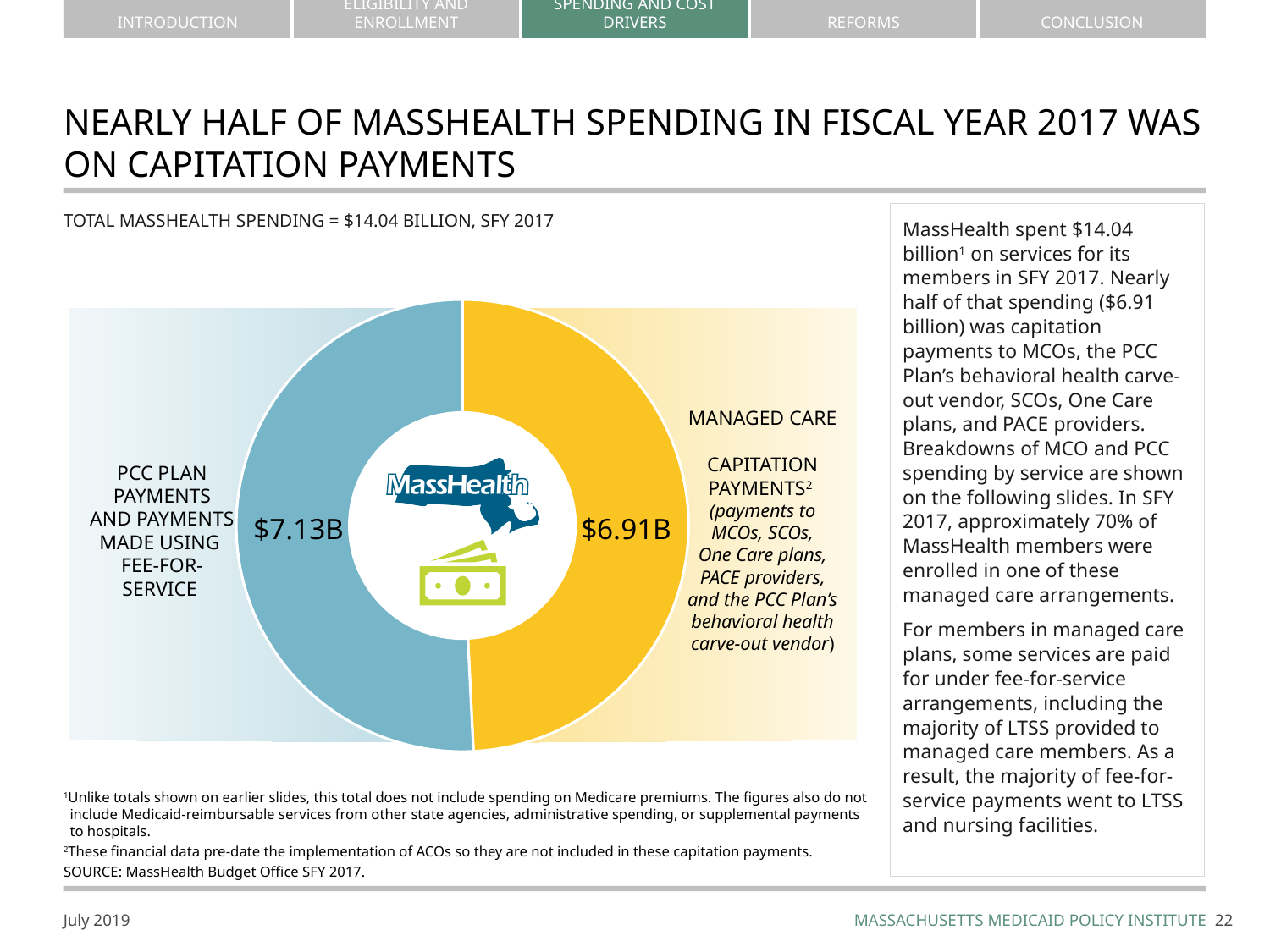
Which is larger: PCC Plan/fee-for-service payments or managed care capitation payments? PCC Plan/fee-for-service payments What is the difference between the PCC Plan/fee-for-service payments and the managed care capitation payments? $0.22B Which segment of the chart is the smallest? Managed care capitation payments What colour is the managed care capitation payments segment? Yellow What is the subtitle printed above the chart? TOTAL MASSHEALTH SPENDING = $14.04 BILLION, SFY 2017 What kind of chart is shown on the slide? Pie (donut) chart What share of total MassHealth spending was managed care capitation payments? 49.2% Which segment of the chart is the largest? PCC Plan payments and payments made using fee-for-service How many segments does the donut chart have? 2 What is the value shown for managed care capitation payments? $6.91B What is the value shown for PCC Plan payments and payments made using fee-for-service? $7.13B What is the total MassHealth spending shown for SFY 2017? $14.04 billion